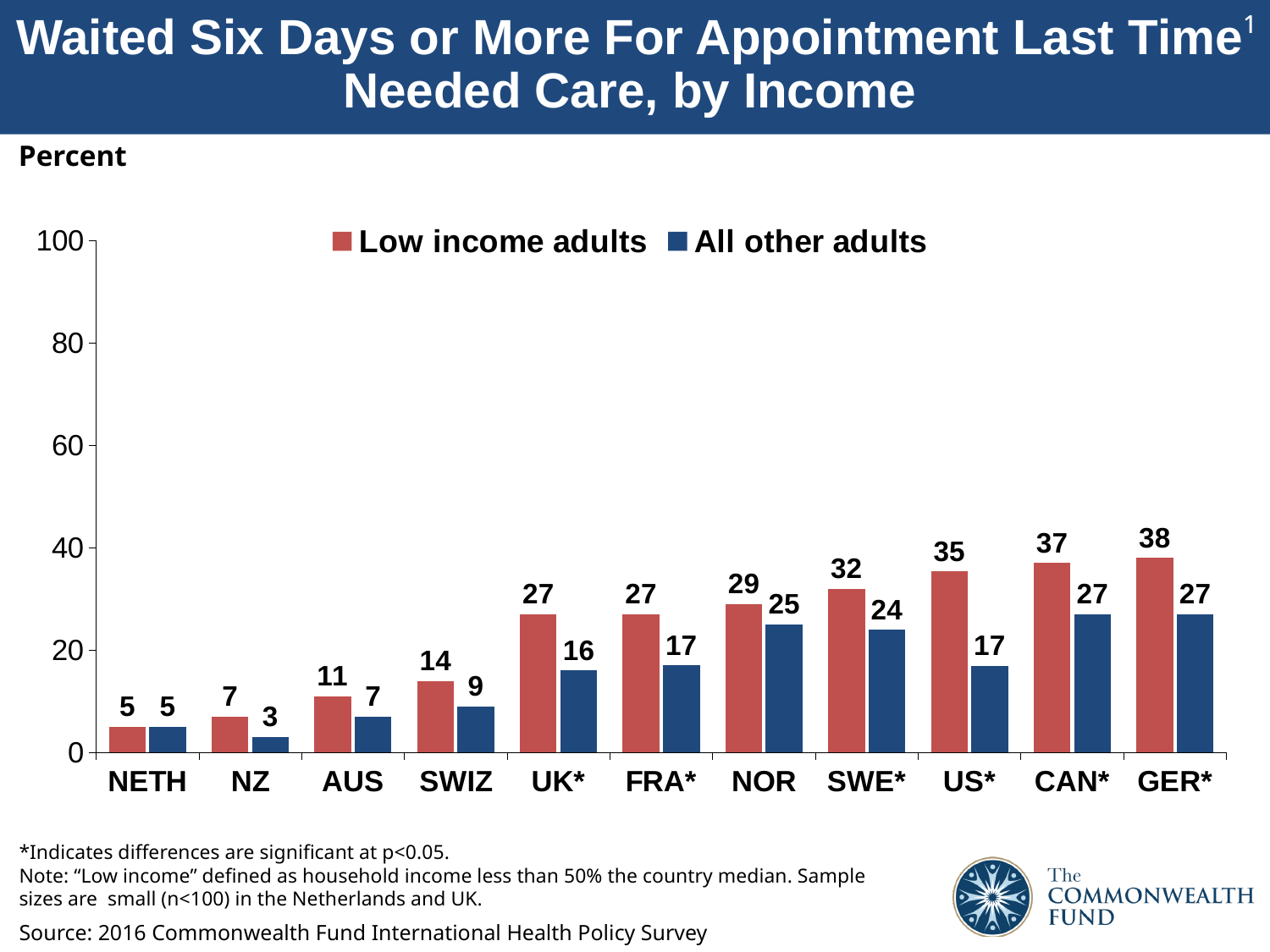
How many series does the legend list? 2 Which country has the highest value for Low income adults? GER* What kind of chart is shown on the slide? Bar chart What is the value for All other adults in UK*? 16 Is the value for Low income adults in CAN* greater or less than 20? greater What is the difference between Low income adults and All other adults in US*? 18 What is the value for Low income adults in GER*? 38 Which country has the lowest value for All other adults? NZ What is the value for All other adults in NOR? 25 How many countries are shown on the x axis? 11 Which colour represents All other adults in the chart? Blue Which is larger in SWE*: Low income adults or All other adults? Low income adults